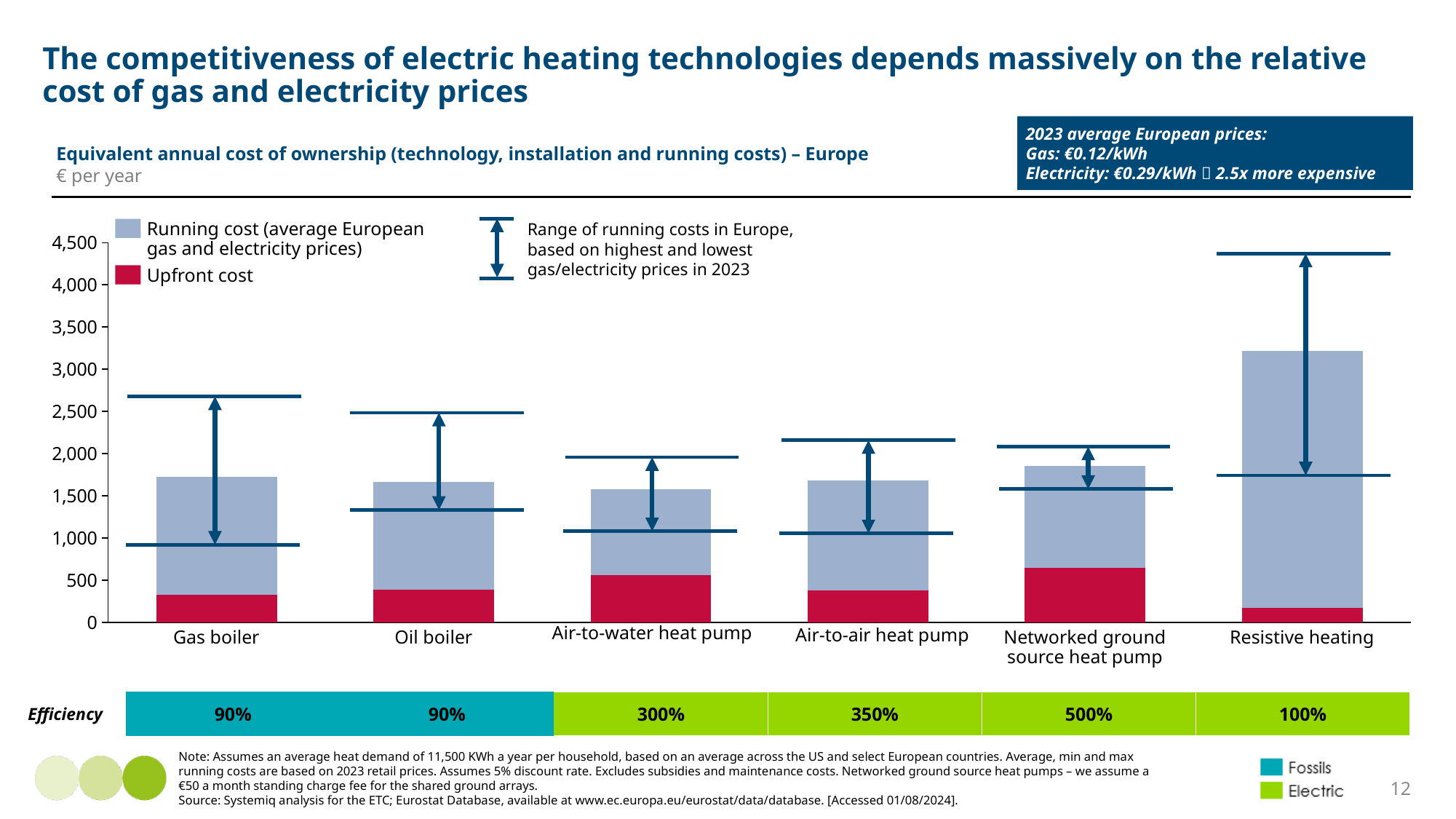
Is the total annual cost of ownership for Resistive heating greater or less than 3,000? greater Which heating technology has the lowest upfront cost? Resistive heating Which heating technology has the highest total equivalent annual cost of ownership? Resistive heating Which has a larger total annual cost of ownership, Resistive heating or Gas boiler? Resistive heating How many cost series does the chart legend list for the stacked bars? 2 What kind of chart is shown on the slide? Stacked bar chart How many heating technologies are shown on the x axis of the chart? 6 Is the total annual cost of ownership for Gas boiler greater or less than 2,000? less Which heating technology has the highest upfront cost? Networked ground source heat pump What unit is the y axis of the chart measured in? € per year What efficiency is shown for the Networked ground source heat pump? 500% Is the upfront cost for Gas boiler greater or less than 500? less